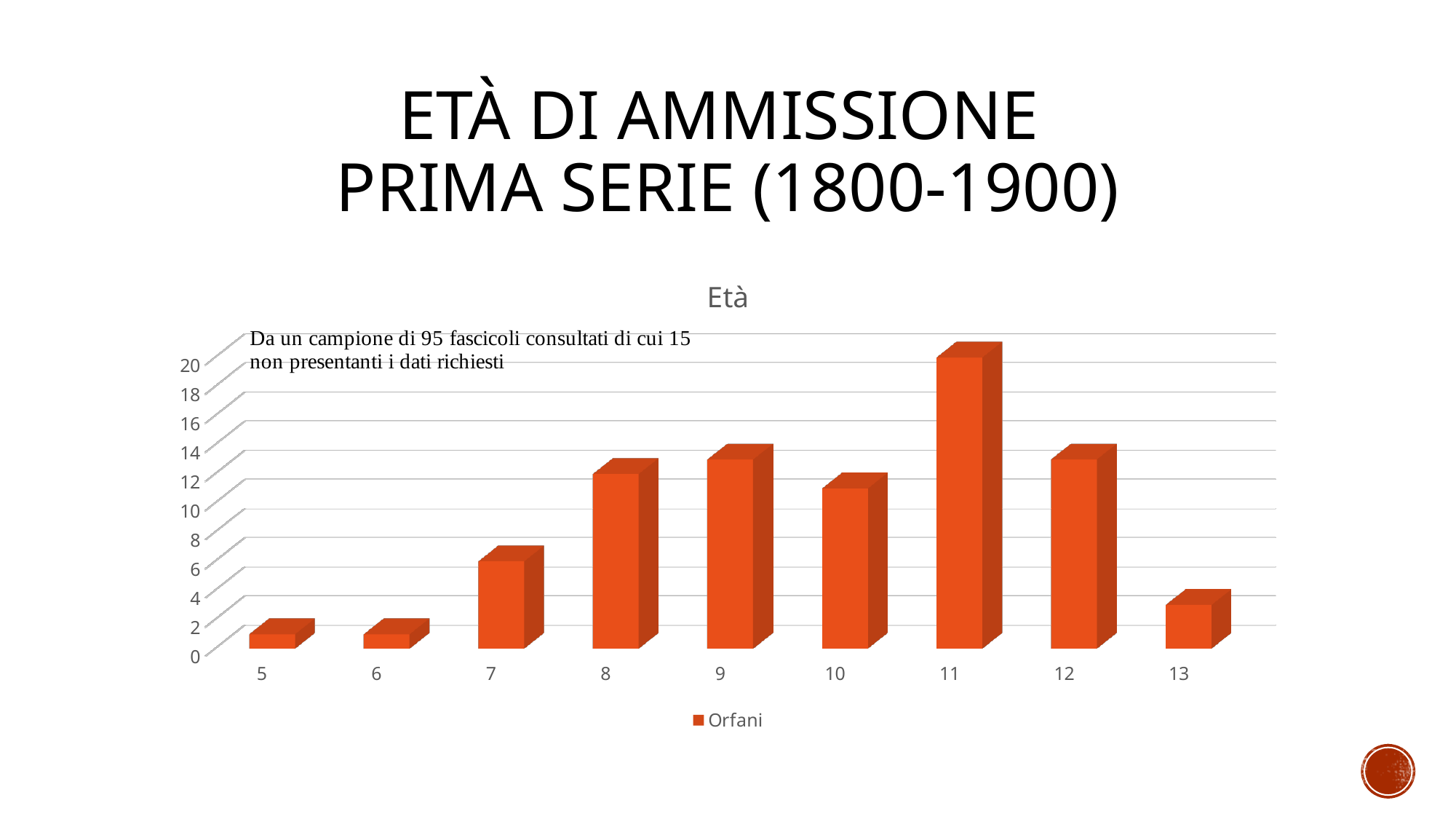
Is the value for age 11 greater or less than 18? greater Is the value for age 5 greater or less than 2? less Do the values rise or fall from age 5 to age 8? rise Which has the larger value, age 11 or age 12? 11 What is the name of the series shown in the legend? Orfani Which age category has the highest value? 11 How many age categories are shown on the x axis? 9 Is the value for age 13 greater or less than 4? less What is the title of the chart? Età What kind of chart is shown on the slide? bar chart How many series does the legend list? 1